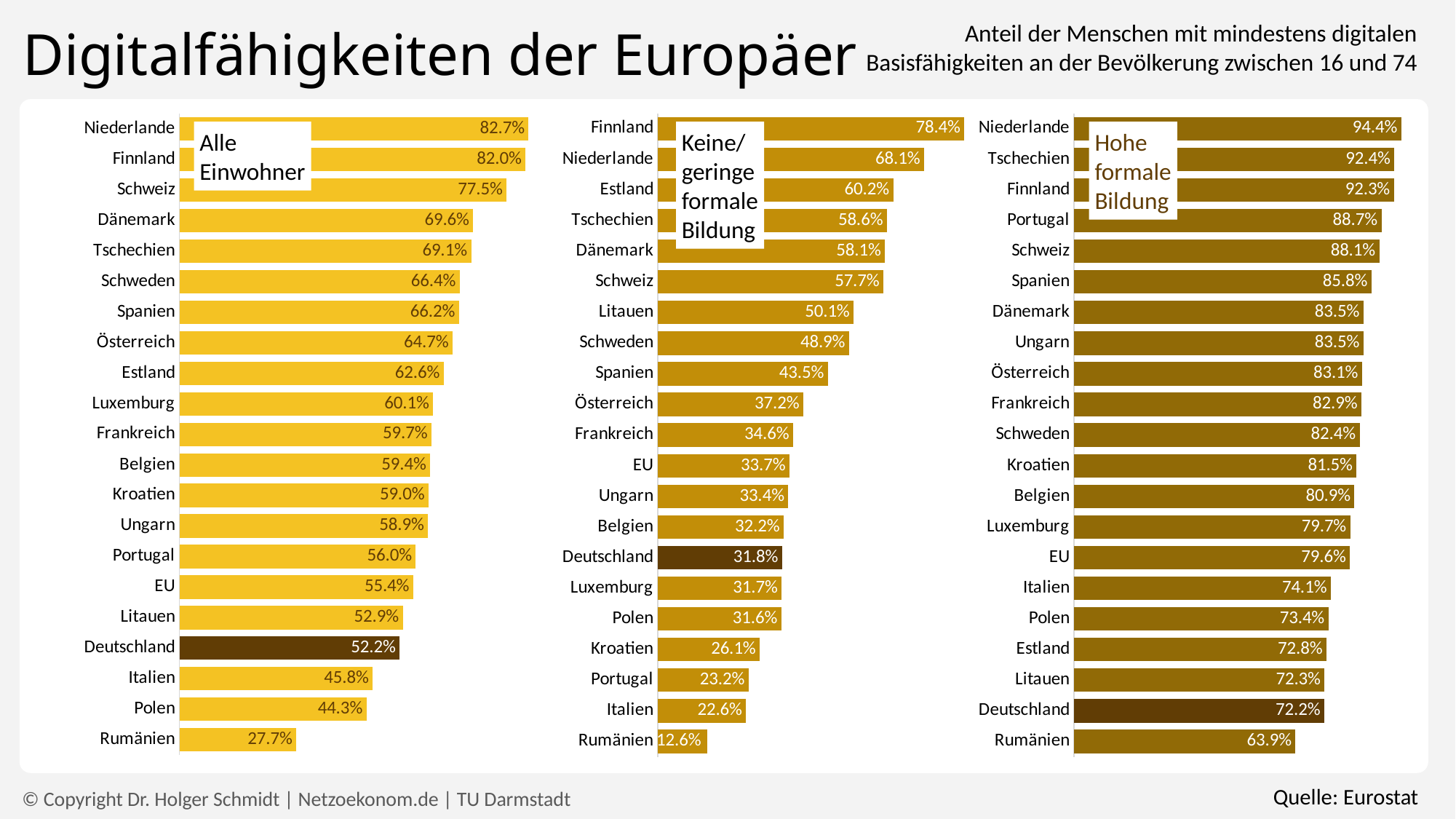
In the 'Alle Einwohner' chart, which country has the highest value? Niederlande In the 'Keine/geringe formale Bildung' chart, what is the value for Finnland? 78.4% In the 'Hohe formale Bildung' chart, what is the difference between Niederlande and Deutschland? 22.2 percentage points What type of chart is the 'Alle Einwohner' chart? Bar chart In the 'Keine/geringe formale Bildung' chart, what is the difference between EU and Deutschland? 1.9 percentage points In the 'Keine/geringe formale Bildung' chart, which country has the lowest value? Rumänien In the 'Hohe formale Bildung' chart, what is the value for EU? 79.6% Which country's bar is highlighted in a darker colour in all three charts? Deutschland In the 'Keine/geringe formale Bildung' chart, which is larger, the value for Spanien or the value for Österreich? Spanien In the 'Alle Einwohner' chart, what is the value for Deutschland? 52.2% How many countries/regions are shown in the 'Hohe formale Bildung' chart? 21 In the 'Alle Einwohner' chart, which is larger, the value for Schweiz or the value for Dänemark? Schweiz